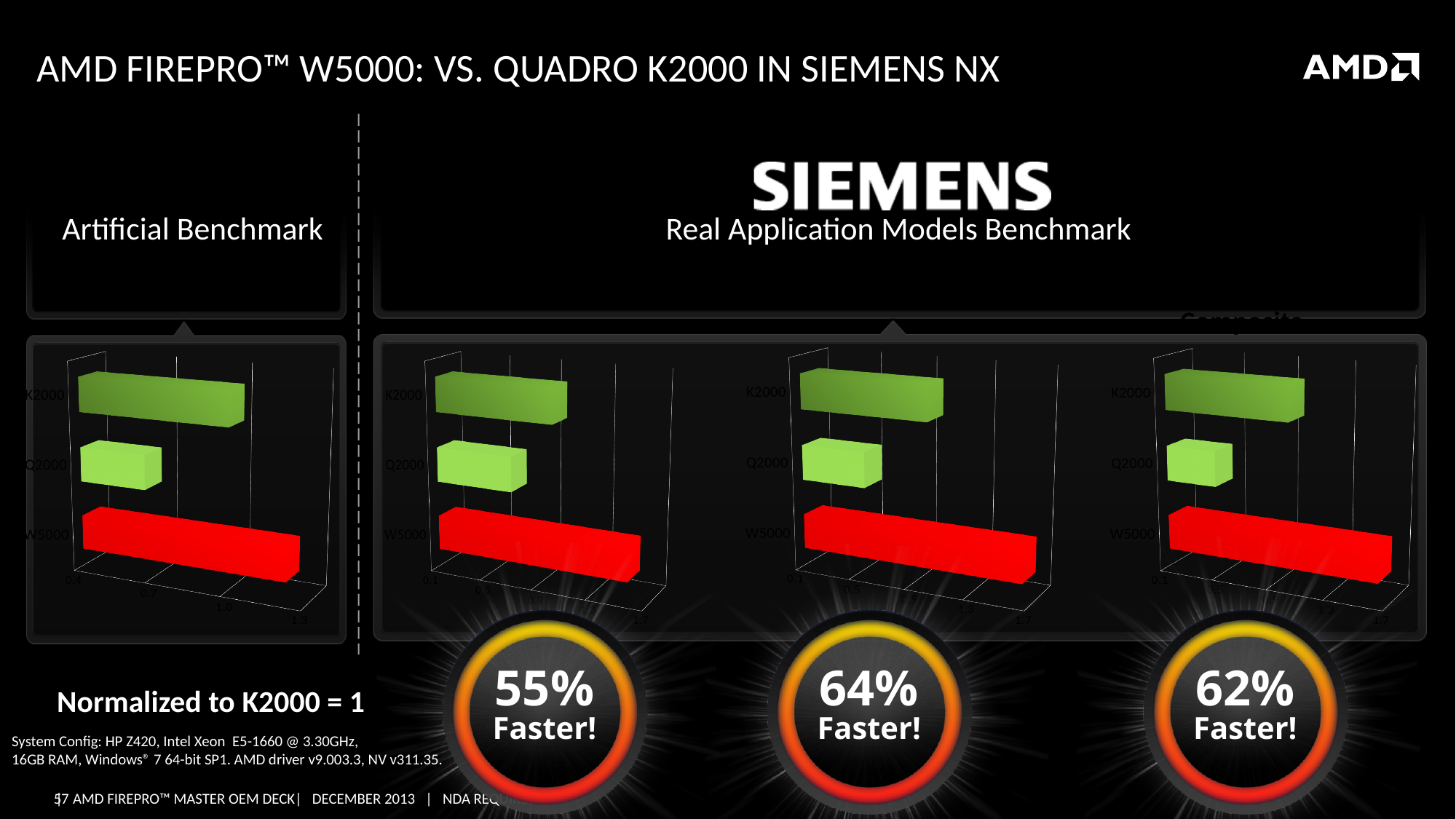
In the Artificial Benchmark chart, which category has the highest value? W5000 How many bar charts are shown on the slide? 4 What colour are the W5000 bars in the charts? red In the Artificial Benchmark chart, is the value for Q2000 greater or less than 1.0? less In the middle Real Application Models Benchmark chart, which category has the lowest value? Q2000 How many categories are shown in the rightmost Real Application Models Benchmark chart? 3 In the Artificial Benchmark chart, is the value for W5000 greater or less than 1.0? greater In the Artificial Benchmark chart, which category has the lowest value? Q2000 What kind of chart is the Artificial Benchmark chart? bar chart In the rightmost Real Application Models Benchmark chart, which category has the highest value? W5000 In the leftmost Real Application Models Benchmark chart, which is larger, W5000 or K2000? W5000 How many categories are shown in the Artificial Benchmark chart? 3